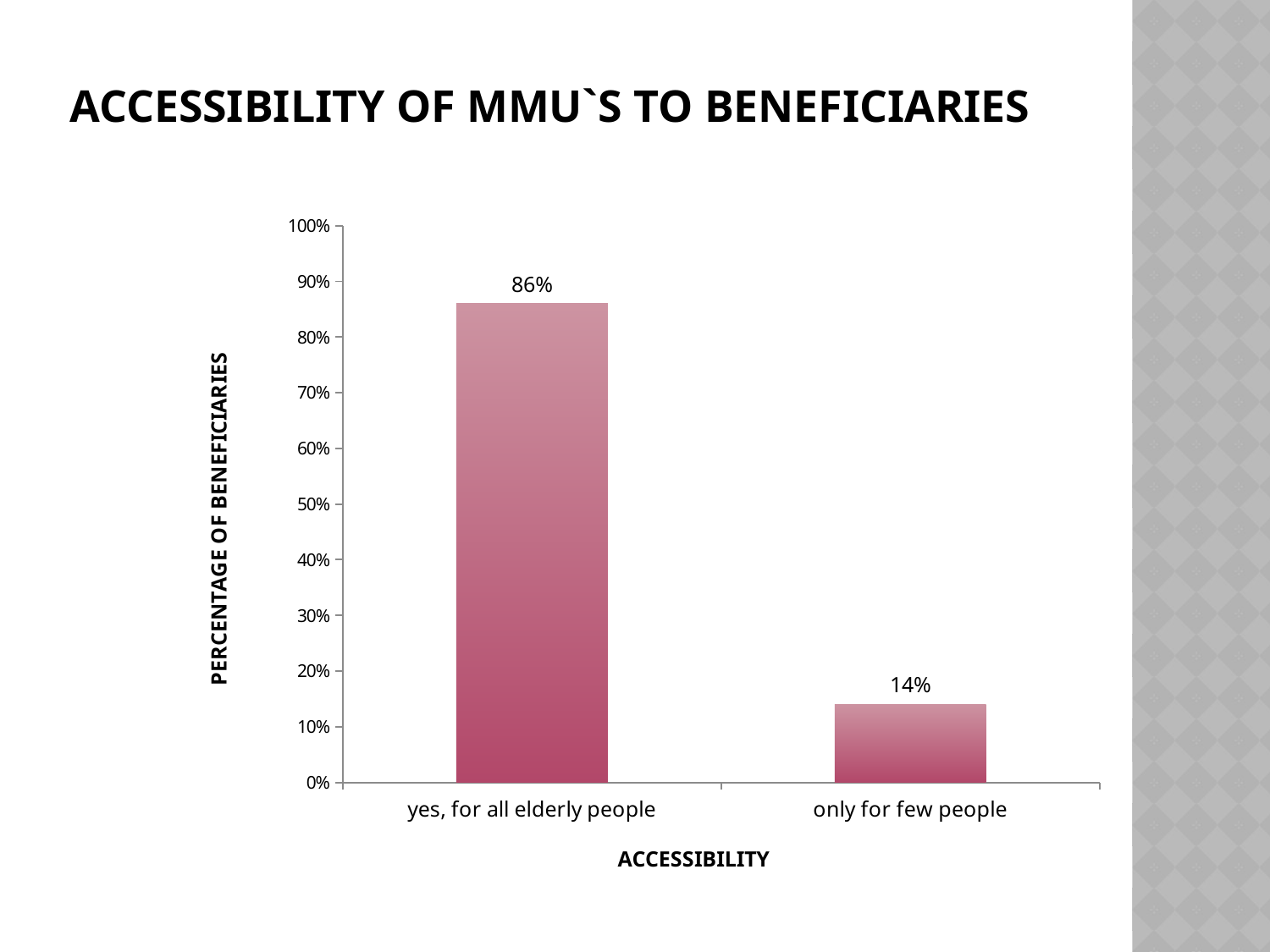
What is the difference between the values for "yes, for all elderly people" and "only for few people"? 72% What is the label of the x axis? ACCESSIBILITY Is the value for "yes, for all elderly people" greater or less than 80%? greater What is the value for "yes, for all elderly people"? 86% How many categories are shown on the x axis? 2 What kind of chart is shown on the slide? bar chart Which category has the highest value? yes, for all elderly people Which is larger: the value for "yes, for all elderly people" or the value for "only for few people"? yes, for all elderly people What is the label of the y axis? PERCENTAGE OF BENEFICIARIES What is the value for "only for few people"? 14% Is the value for "only for few people" greater or less than 20%? less Which category has the lowest value? only for few people